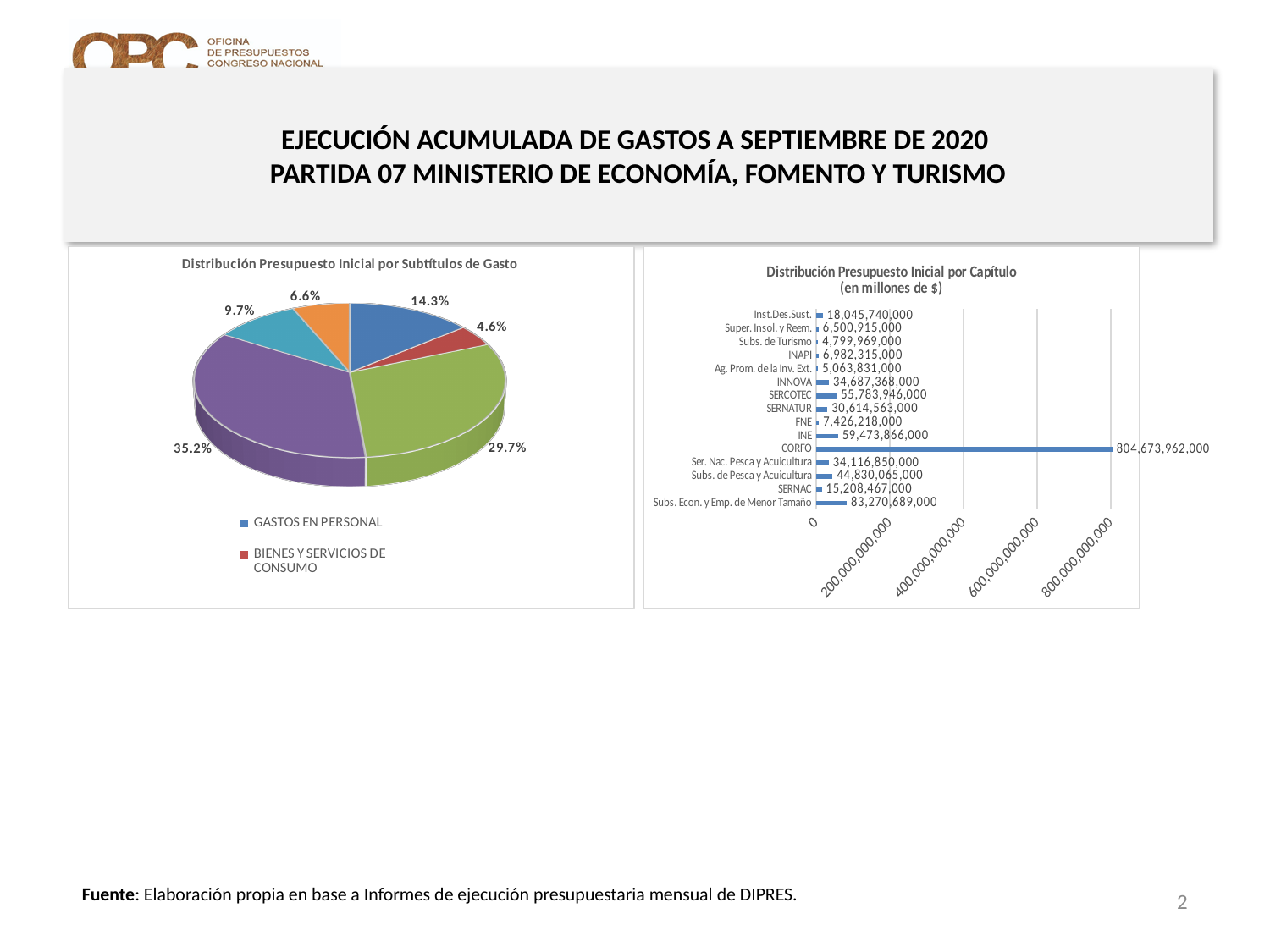
In the chart 'Distribución Presupuesto Inicial por Capítulo', which category has the highest value? CORFO In the chart 'Distribución Presupuesto Inicial por Capítulo', what is the difference between the values for INE and SERCOTEC? 3,689,920,000 In the pie chart 'Distribución Presupuesto Inicial por Subtítulos de Gasto', what is the largest percentage shown on any slice? 35.2% In the pie chart 'Distribución Presupuesto Inicial por Subtítulos de Gasto', what percentage is shown for BIENES Y SERVICIOS DE CONSUMO? 4.6% In the pie chart 'Distribución Presupuesto Inicial por Subtítulos de Gasto', what percentage is shown for GASTOS EN PERSONAL? 14.3% In the chart 'Distribución Presupuesto Inicial por Capítulo', which category has the lowest value? Subs. de Turismo In the chart 'Distribución Presupuesto Inicial por Capítulo', what is the value for CORFO? 804,673,962,000 In the pie chart 'Distribución Presupuesto Inicial por Subtítulos de Gasto', which is larger: the share for GASTOS EN PERSONAL or the share for BIENES Y SERVICIOS DE CONSUMO? GASTOS EN PERSONAL In the pie chart 'Distribución Presupuesto Inicial por Subtítulos de Gasto', how many slices does the pie have? 6 In the chart 'Distribución Presupuesto Inicial por Capítulo', how many categories are plotted? 15 In the chart 'Distribución Presupuesto Inicial por Capítulo', what is the value for SERCOTEC? 55,783,946,000 What kind of chart is 'Distribución Presupuesto Inicial por Capítulo'? Bar chart